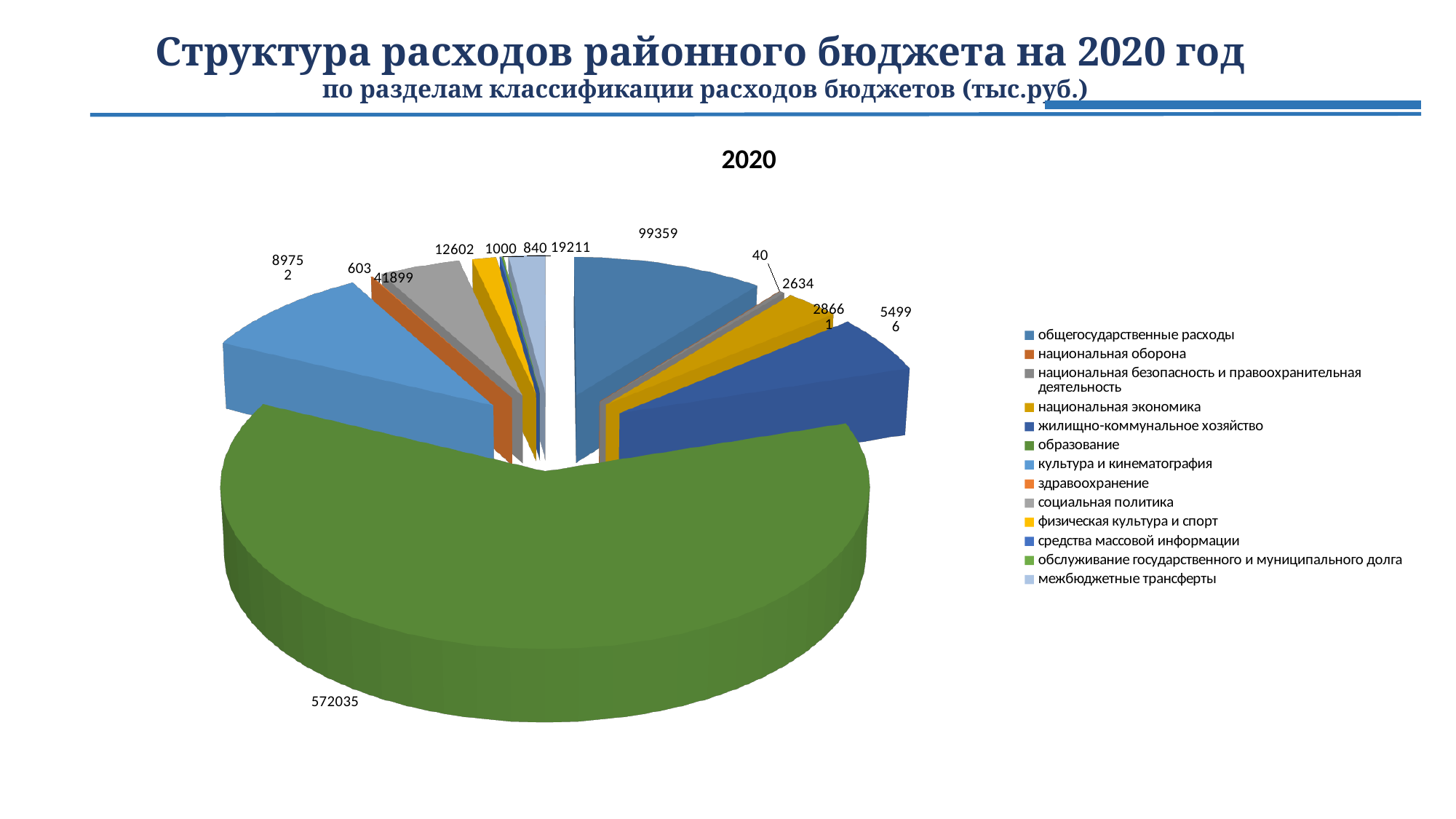
What is the value for образование? 572035 What is the value for межбюджетные трансферты? 19211 Which category has the largest slice in the pie chart? образование What kind of chart is shown on the slide? pie chart What is the value for общегосударственные расходы? 99359 How many categories does the legend of the pie chart list? 13 Which is larger, the value for физическая культура и спорт or the value for межбюджетные трансферты? межбюджетные трансферты Which category has the smallest value in the pie chart? национальная оборона What is the value for социальная политика? 41899 What is the difference between the values for общегосударственные расходы and социальная политика? 57460 What title is shown directly above the pie chart? 2020 What is the value for национальная оборона? 40